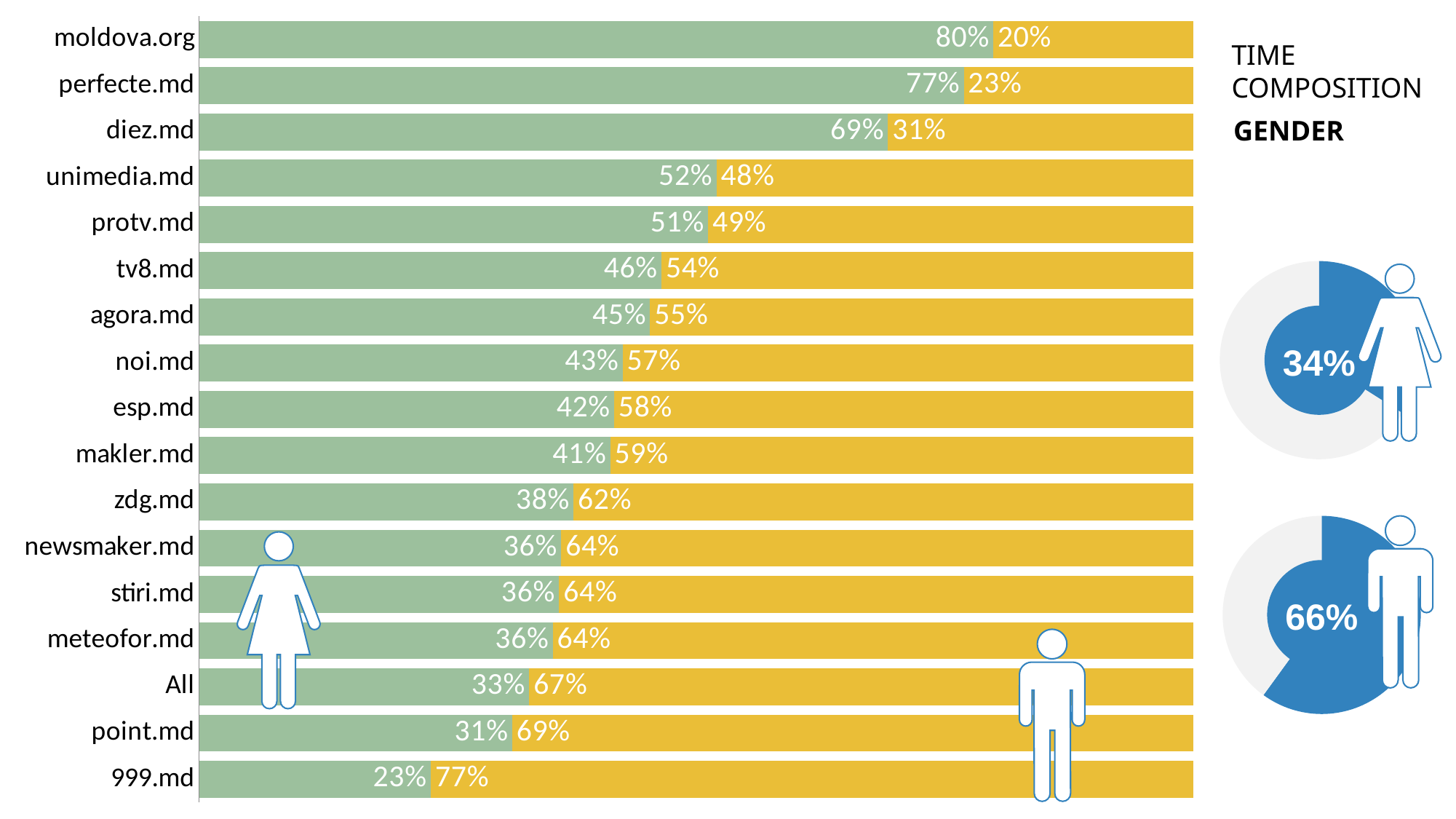
Do the green segment values increase or decrease going from the top bar to the bottom bar? Decrease Which has a larger green segment, unimedia.md or tv8.md? unimedia.md How many bars (categories) are shown in the chart? 17 What percentage is shown next to the female icon on the right side of the slide? 34% What is the difference between the green segment of moldova.org and the green segment of 999.md? 57 percentage points Which category has the largest green segment? moldova.org What is the total of the two segments in the perfecte.md bar? 100% What is the green (left) segment value for diez.md? 69% What is the yellow (right) segment value for noi.md? 57% Which category has the smallest green segment? 999.md What is the green segment value for the 'All' bar? 33% What kind of chart is shown on the slide? Stacked horizontal bar chart